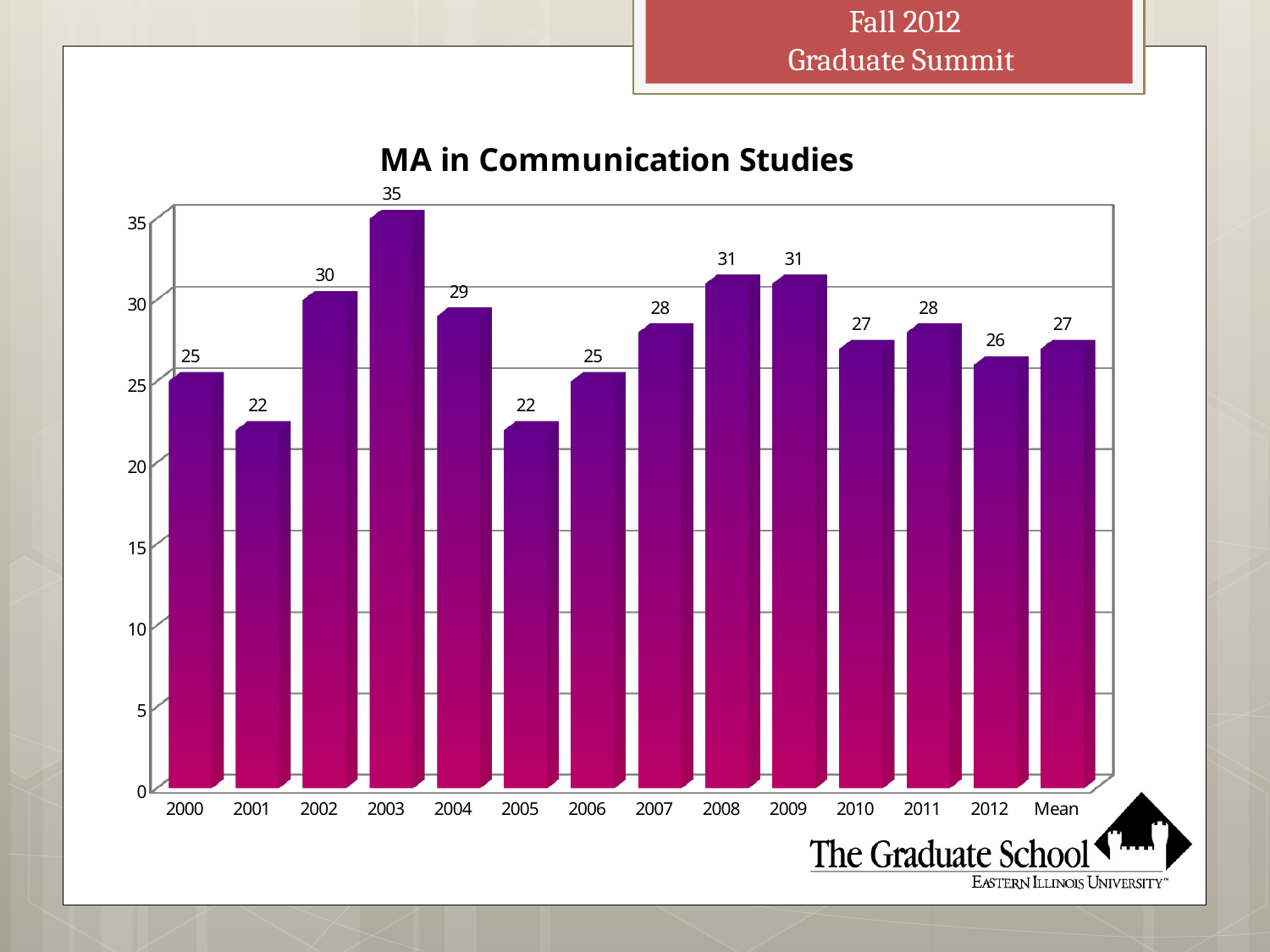
What is the value for 2008? 31 What is the value for 2003? 35 Is the value for 2012 greater or less than 25? greater Which year has the highest value? 2003 Which is larger, the value for 2002 or the value for 2004? 2002 What kind of chart is this? bar chart Do the values rise or fall from 2005 to 2008? rise What is the difference between the values for 2003 and 2005? 13 What is the value shown for Mean? 27 What is the lowest value shown on the chart? 22 What is the title of the chart? MA in Communication Studies How many categories are shown on the x axis? 14